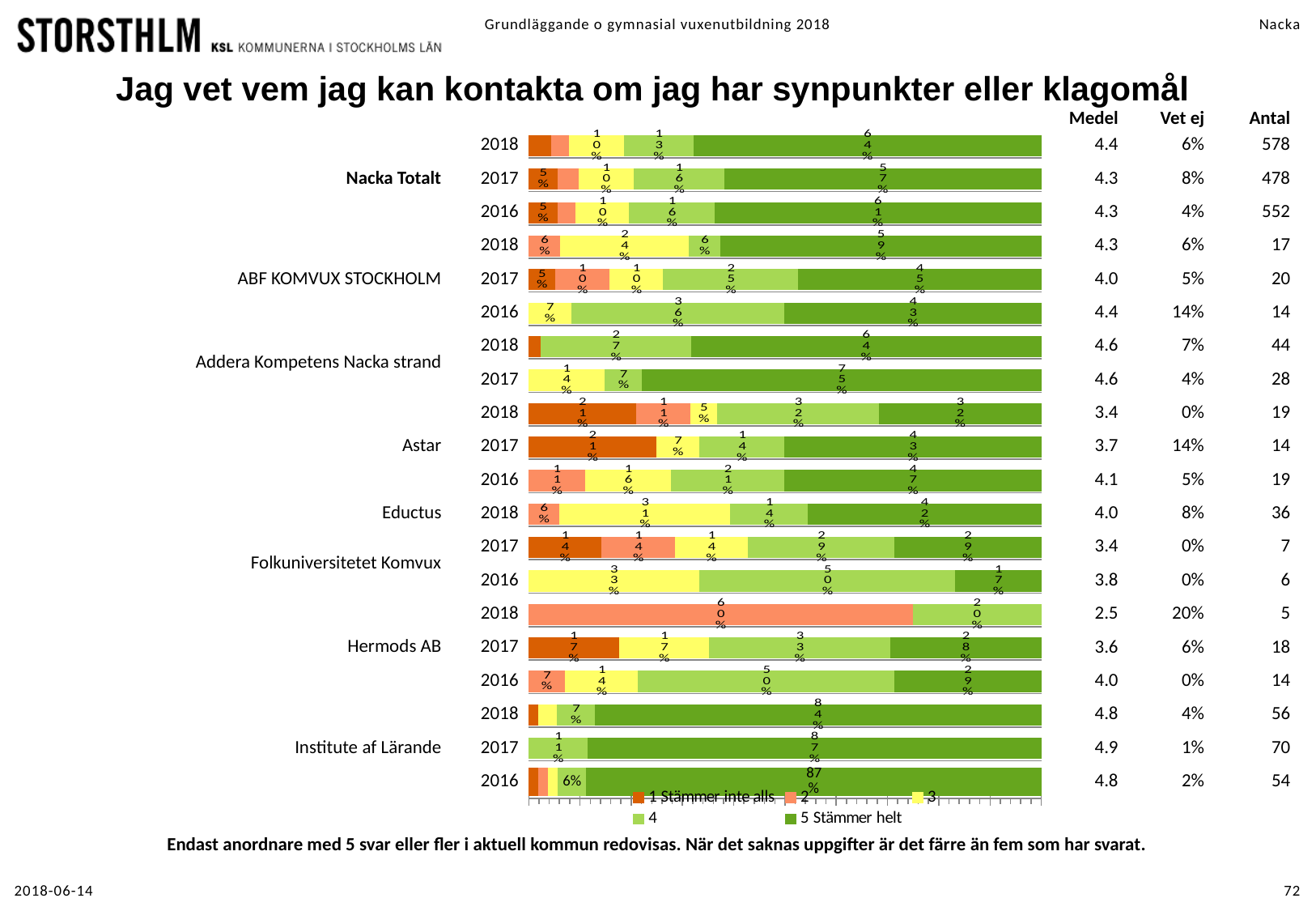
What is the share of '5 Stämmer helt' for Institute af Lärande in 2016? 87% What is the share of '5 Stämmer helt' for Nacka Totalt in 2017? 57% How many series does the legend list? 5 How many bars are plotted in the chart? 20 For Nacka Totalt, which year has the larger share of '5 Stämmer helt', 2018 or 2017? 2018 What is the share of series '2' for Hermods AB in 2018? 60% What kind of chart is shown on the slide? bar chart What is the difference in the '5 Stämmer helt' share for Nacka Totalt between 2018 and 2017? 7 percentage points What is the share of '5 Stämmer helt' for Addera Kompetens Nacka strand in 2017? 75% What is the legend label for the dark green series? 5 Stämmer helt What is the share of '5 Stämmer helt' for Nacka Totalt in 2018? 64% What is the share of '5 Stämmer helt' for Institute af Lärande in 2018? 84%